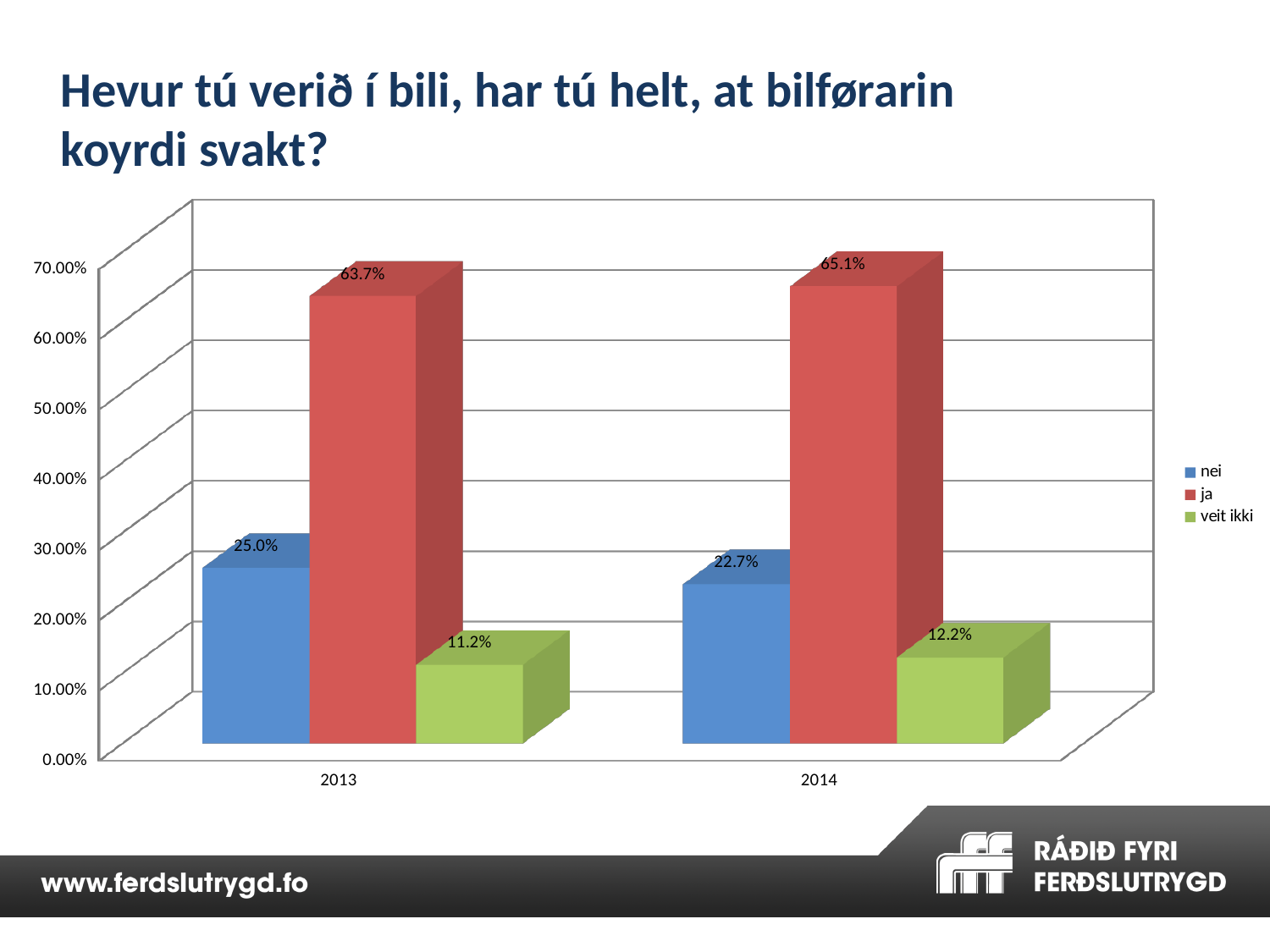
What is the value for "ja" in 2013? 63.7% What is the value for "nei" in 2014? 22.7% What is the value for "ja" in 2014? 65.1% Does the value for "veit ikki" rise or fall from 2013 to 2014? rise What kind of chart is shown on the slide? bar chart Which is larger: "nei" in 2013 or "nei" in 2014? nei in 2013 What is the value for "veit ikki" in 2013? 11.2% What is the difference between the "ja" values for 2014 and 2013? 1.4% Which series has the highest value in 2014? ja How many series does the legend list? 3 How many year categories are shown on the x axis? 2 Which series has the lowest value in 2013? veit ikki